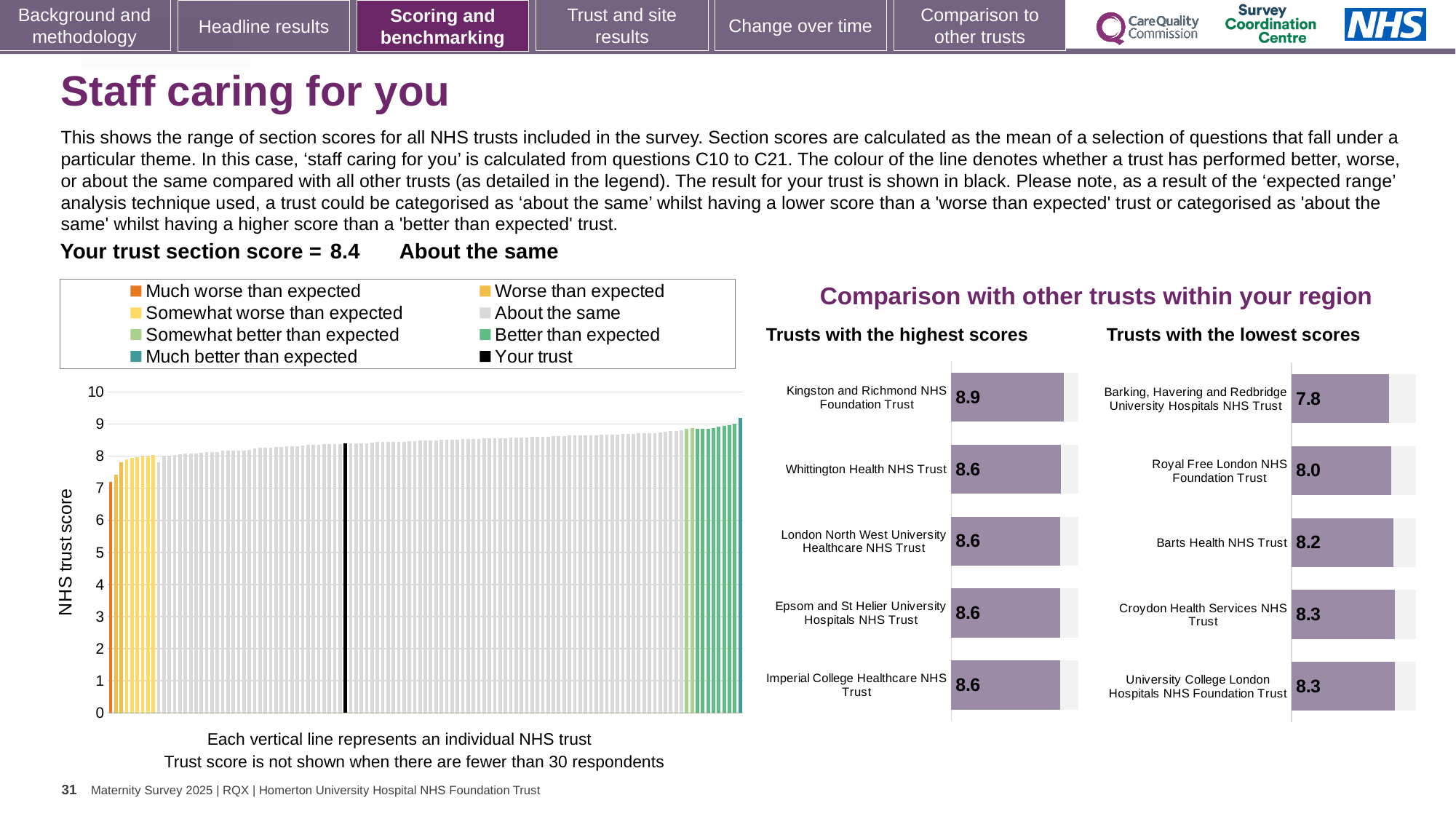
In the 'Trusts with the lowest scores' chart, what is the score for Barts Health NHS Trust? 8.2 In the large chart on the left, do the trust scores rise or fall from left to right? rise In the large chart on the left, is the value for the black 'Your trust' bar greater or less than 8? greater How many entries does the legend above the large chart on the left list? 8 In the 'Trusts with the lowest scores' chart, what is the score for Barking, Havering and Redbridge University Hospitals NHS Trust? 7.8 In the 'Trusts with the highest scores' chart, what is the score for Kingston and Richmond NHS Foundation Trust? 8.9 In the 'Trusts with the lowest scores' chart, which has the larger score: Royal Free London NHS Foundation Trust or Barts Health NHS Trust? Barts Health NHS Trust What kind of chart is the large chart on the left of the slide? bar chart In the 'Trusts with the highest scores' chart, what is the difference between the scores of Kingston and Richmond NHS Foundation Trust and Whittington Health NHS Trust? 0.3 How many trusts are shown in the 'Trusts with the lowest scores' chart? 5 In the 'Trusts with the highest scores' chart, which trust has the highest score? Kingston and Richmond NHS Foundation Trust In the 'Trusts with the lowest scores' chart, which trust has the lowest score? Barking, Havering and Redbridge University Hospitals NHS Trust